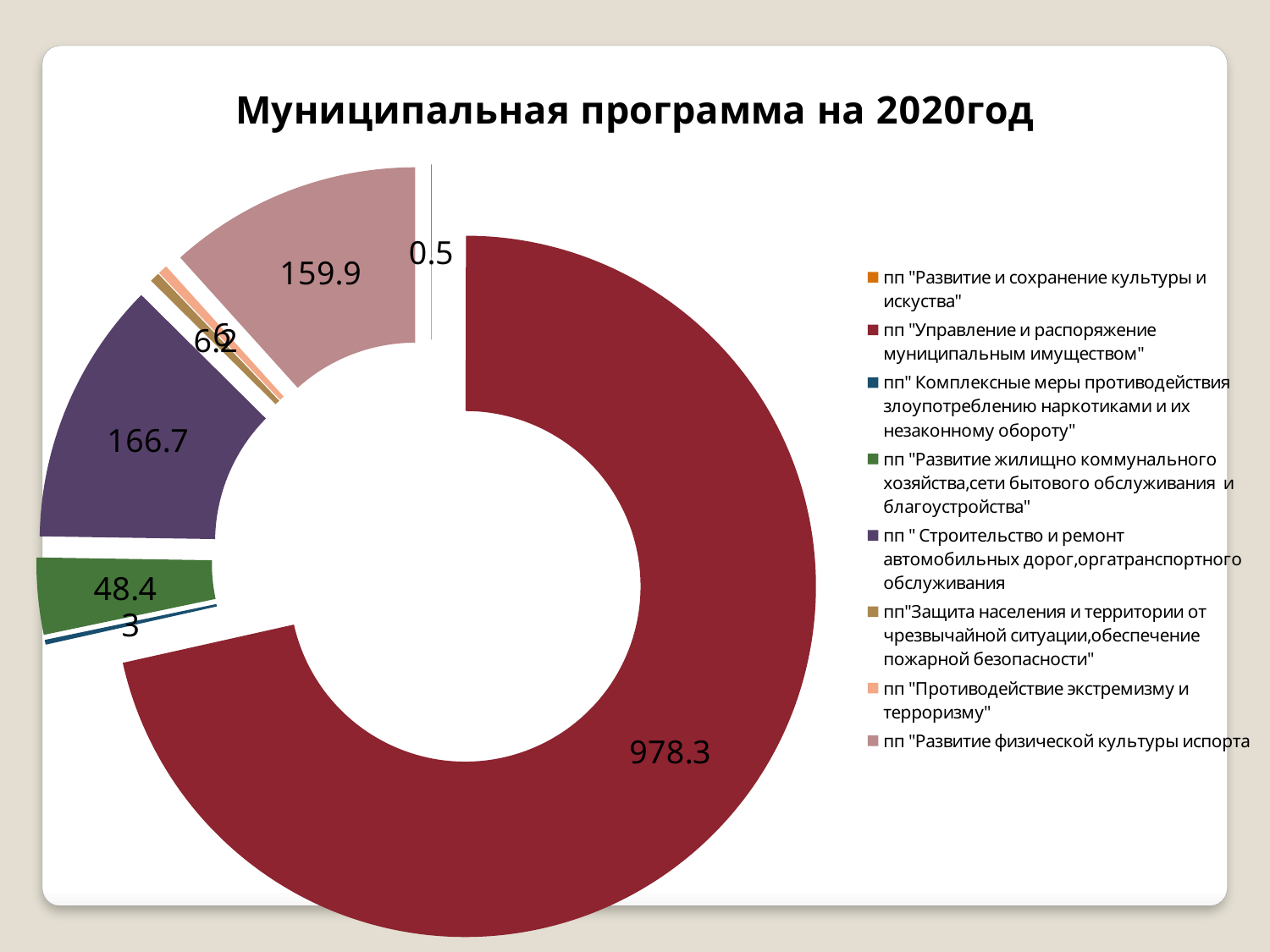
Which is larger: the value for пп "Развитие жилищно коммунального хозяйства,сети бытового обслуживания и благоустройства" or the value for пп "Развитие физической культуры испорта? пп "Развитие физической культуры испорта What is the value for пп " Строительство и ремонт автомобильных дорог,оргатранспортного обслуживания? 166.7 How many entries does the chart legend list? 8 What is the title of the chart? Муниципальная программа на 2020год What is the value for пп "Развитие физической культуры испорта? 159.9 What is the value for пп "Развитие жилищно коммунального хозяйства,сети бытового обслуживания и благоустройства"? 48.4 What is the difference between the values for пп " Строительство и ремонт автомобильных дорог,оргатранспортного обслуживания and пп "Развитие физической культуры испорта? 6.8 Which program has the largest slice of the chart? пп "Управление и распоряжение муниципальным имуществом" Which program has the smallest slice of the chart? пп "Развитие и сохранение культуры и искуства" What is the value for пп "Развитие и сохранение культуры и искуства"? 0.5 What is the value for пп "Управление и распоряжение муниципальным имуществом"? 978.3 What kind of chart is shown on the slide? doughnut (pie) chart